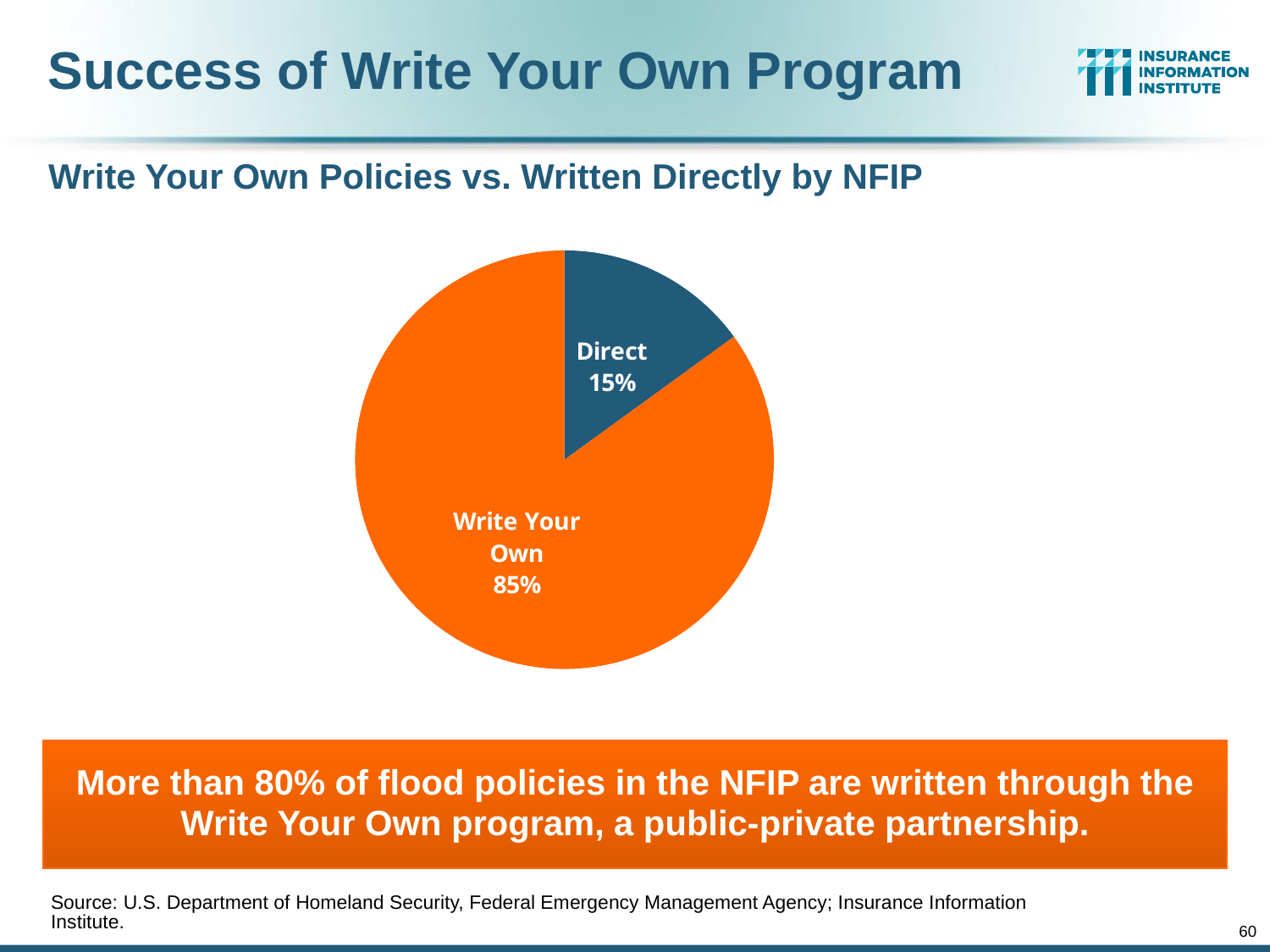
How many slices does the pie chart have? 2 Which is larger, the Direct slice or the Write Your Own slice? Write Your Own Which slice of the pie is the largest? Write Your Own What share of the pie is labelled Write Your Own? 85% What colour is the Direct slice of the pie? dark blue What is the difference in percentage points between the Write Your Own slice and the Direct slice? 70 percentage points What is the title of the chart on the slide? Write Your Own Policies vs. Written Directly by NFIP Which slice of the pie is the smallest? Direct What share of the pie is labelled Direct? 15% What kind of chart is shown on the slide? pie chart